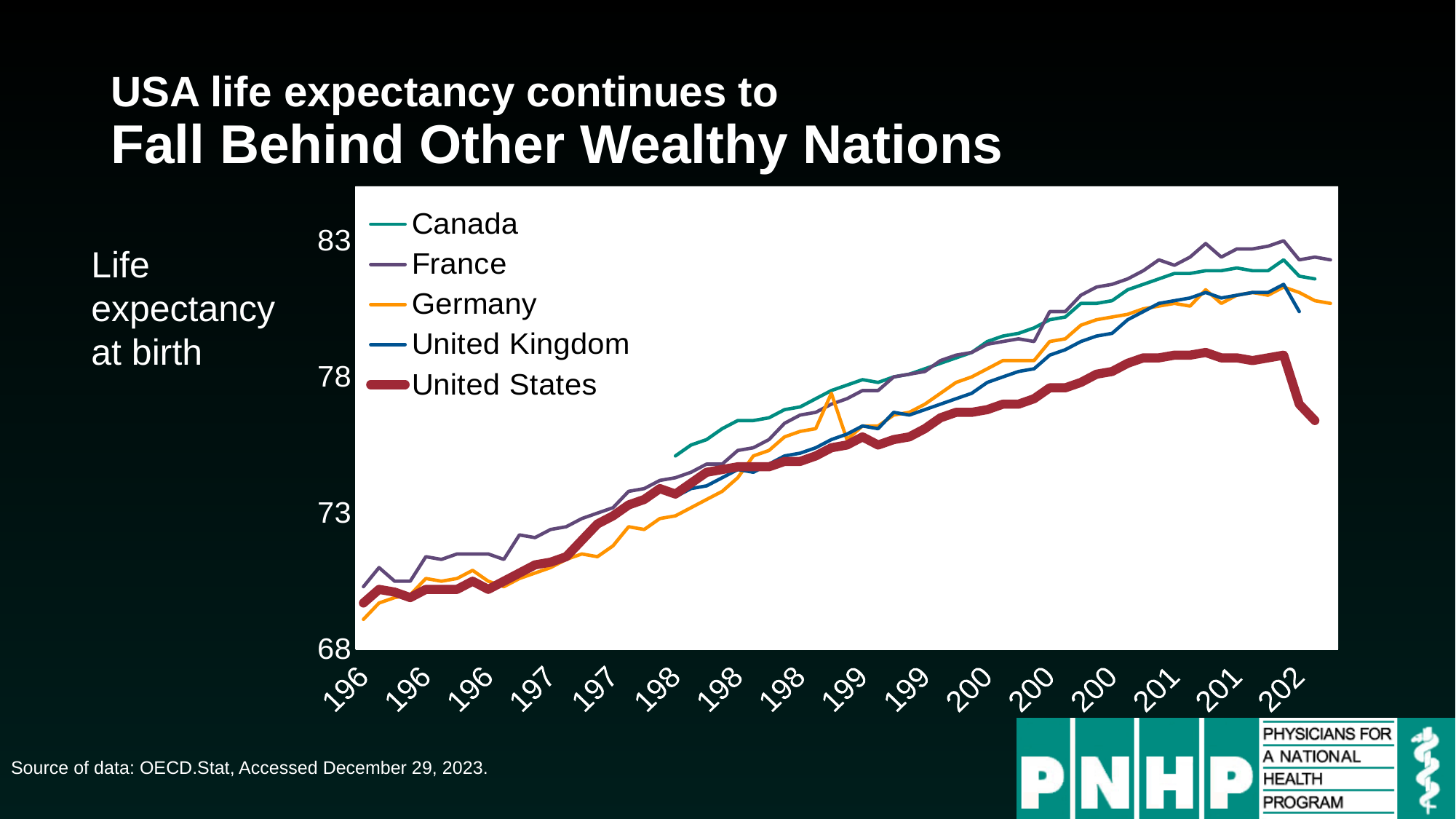
Overall, do the life expectancy values rise or fall from left to right across the chart? rise Is the first value for Germany greater or less than 73? less Does the United States line rise or fall over the last few points on the chart? fall Is the final value for Canada greater or less than 78? greater Is the final value for France greater or less than 78? greater At the right end of the chart, which is higher: France or United States? France Which series has the highest life expectancy at the right end of the chart? France How many series does the legend list? 5 Which series has the lowest life expectancy at the right end of the chart? United States Which series is drawn with the thickest line on the chart? United States What kind of chart is shown on the slide? line chart